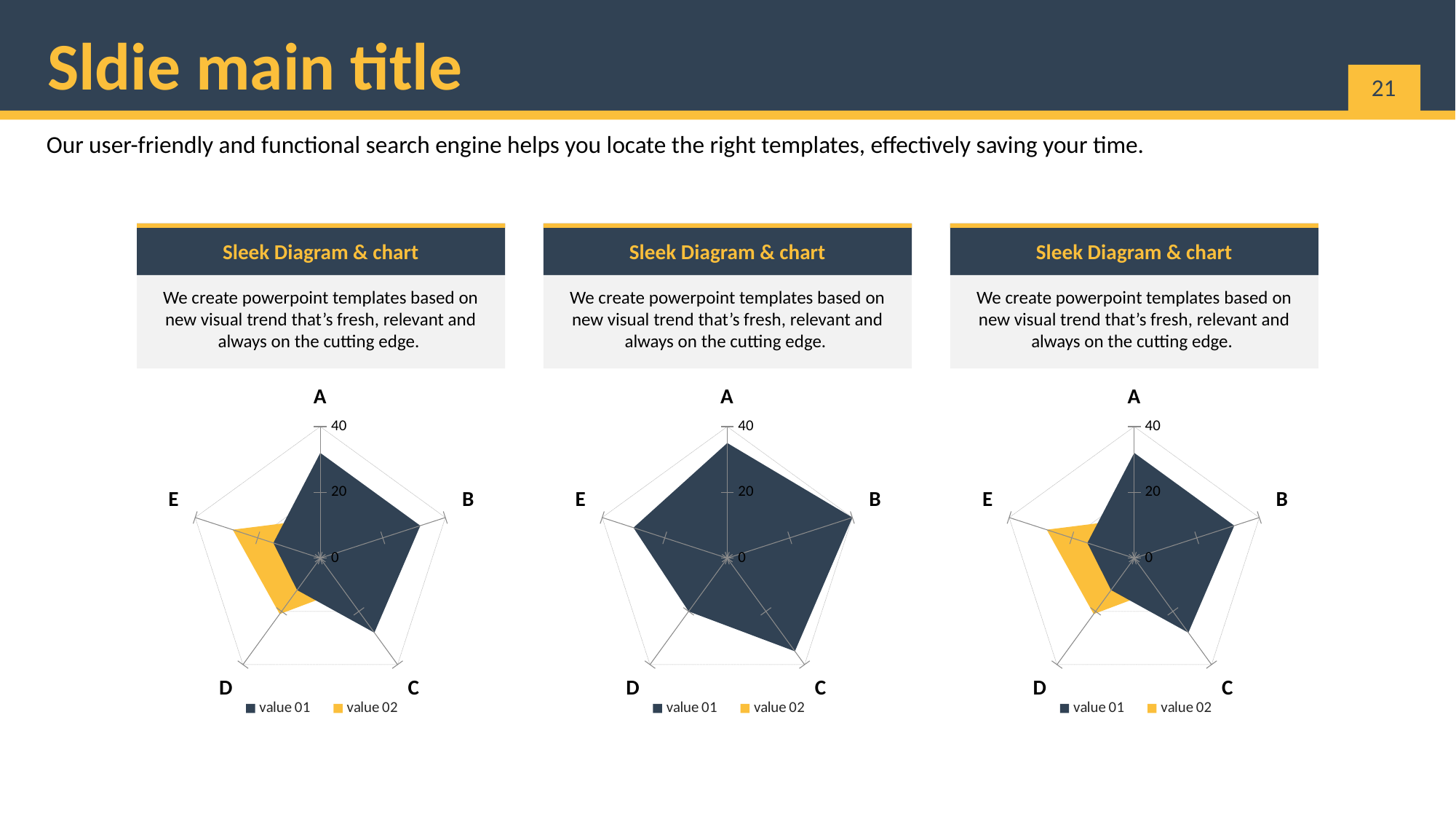
How many categories does the middle radar chart have? 5 What kind of chart is the left chart on the slide? radar chart In the left radar chart, which is larger for value 01: B or E? B In the middle radar chart, is the value 01 for A greater or less than 20? greater In the middle radar chart, is the value 01 for E greater or less than 20? greater In the left radar chart, is the value 01 for A greater or less than 20? greater What are the two legend entries of the left radar chart? value 01, value 02 What is the highest axis tick value shown on the right radar chart? 40 In the middle radar chart, which is larger for value 01: B or D? B How many series does the legend of the right radar chart list? 2